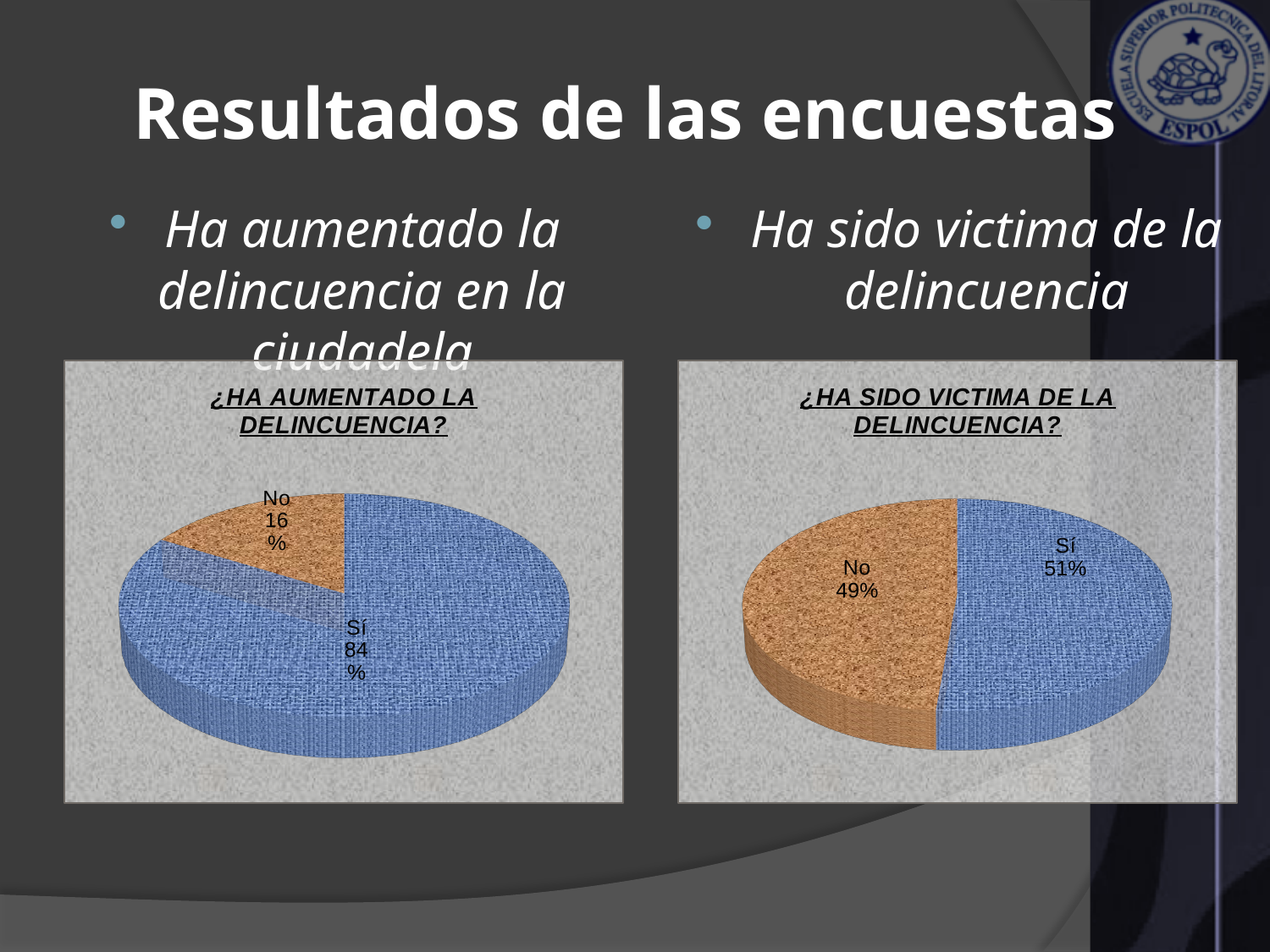
In the right chart, '¿HA SIDO VICTIMA DE LA DELINCUENCIA?', what percentage answered Sí? 51% In the left chart, which response has the smallest share? No In the left chart, which response has the largest share? Sí In the right chart, which response has the larger share, Sí or No? Sí In the left chart, '¿HA AUMENTADO LA DELINCUENCIA?', what percentage answered No? 16% What is the title of the left chart? ¿HA AUMENTADO LA DELINCUENCIA? What type of chart is used on the left side of the slide? Pie chart In the left chart, '¿HA AUMENTADO LA DELINCUENCIA?', what percentage answered Sí? 84% In the left chart, what is the difference in percentage points between Sí and No? 68 In the right chart, '¿HA SIDO VICTIMA DE LA DELINCUENCIA?', what percentage answered No? 49% In the right chart, what is the difference in percentage points between Sí and No? 2 How many slices does the right chart, '¿HA SIDO VICTIMA DE LA DELINCUENCIA?', have? 2